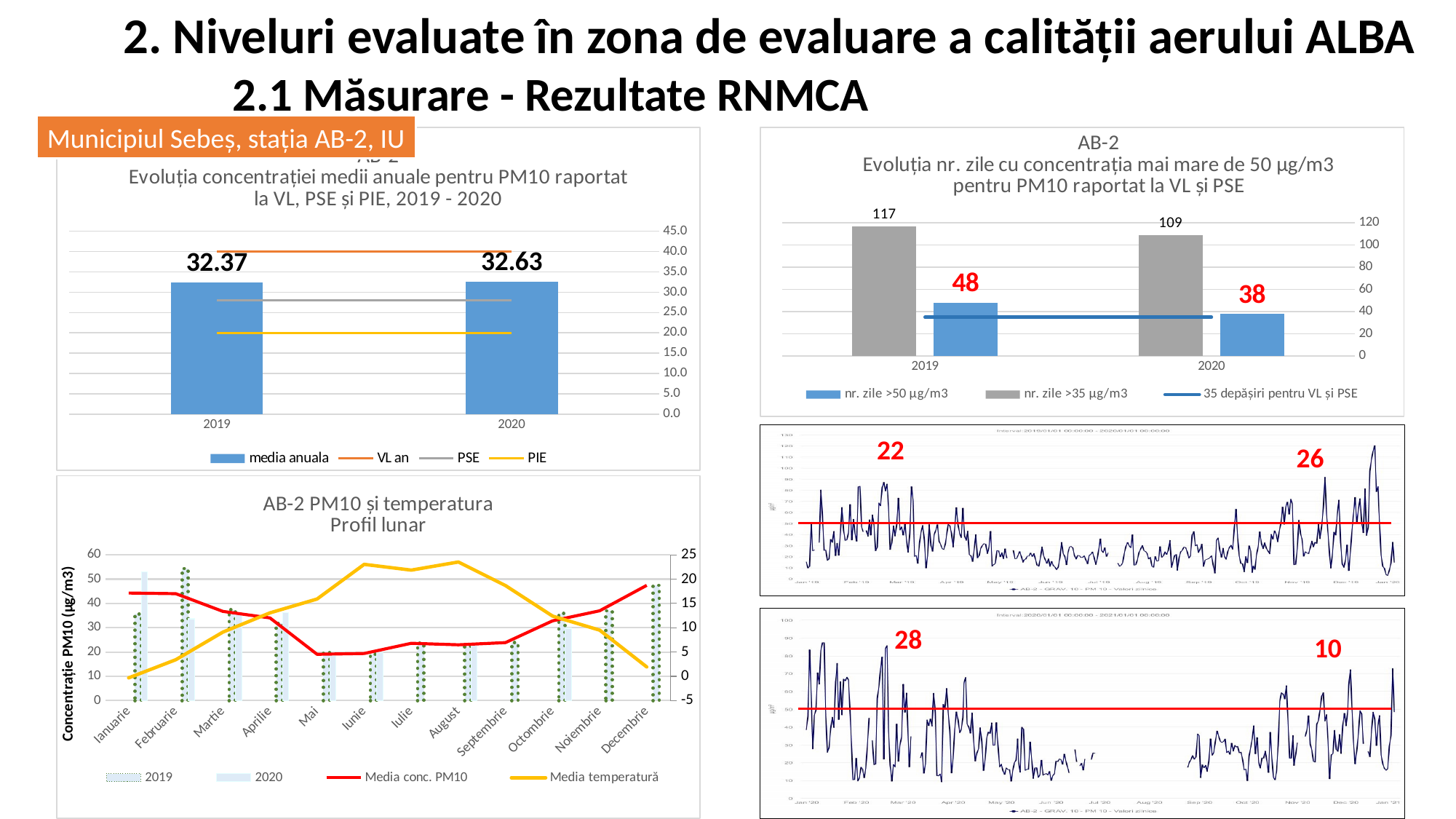
In the chart 'Evoluția concentrației medii anuale pentru PM10 raportat la VL, PSE și PIE, 2019 - 2020', what is the annual mean value for 2019? 32.37 In the chart 'Evoluția nr. zile cu concentrația mai mare de 50 µg/m3 pentru PM10 raportat la VL și PSE', how many series does the legend list? 3 In the chart 'Evoluția concentrației medii anuale pentru PM10 raportat la VL, PSE și PIE, 2019 - 2020', what is the annual mean value for 2020? 32.63 In the chart 'Evoluția nr. zile cu concentrația mai mare de 50 µg/m3 pentru PM10 raportat la VL și PSE', which year has the higher number of days >35 µg/m3? 2019 In the chart 'AB-2 PM10 și temperatura Profil lunar', what is the label of the y axis on the left? Concentrație PM10 (µg/m3) In the chart 'Evoluția nr. zile cu concentrația mai mare de 50 µg/m3 pentru PM10 raportat la VL și PSE', what is the number of days >50 µg/m3 in 2020? 38 In the chart 'Evoluția nr. zile cu concentrația mai mare de 50 µg/m3 pentru PM10 raportat la VL și PSE', what is the number of days >35 µg/m3 in 2019? 117 In the chart 'AB-2 PM10 și temperatura Profil lunar', how many series does the legend list? 4 In the chart 'Evoluția nr. zile cu concentrația mai mare de 50 µg/m3 pentru PM10 raportat la VL și PSE', what is the difference between the number of days >35 µg/m3 in 2019 and in 2020? 8 In the chart 'Evoluția concentrației medii anuale pentru PM10 raportat la VL, PSE și PIE, 2019 - 2020', how many series does the legend list? 4 In the chart 'Evoluția nr. zile cu concentrația mai mare de 50 µg/m3 pentru PM10 raportat la VL și PSE', what is the difference between the number of days >50 µg/m3 in 2019 and in 2020? 10 In the chart 'AB-2 PM10 și temperatura Profil lunar', how many months are shown on the x axis? 12